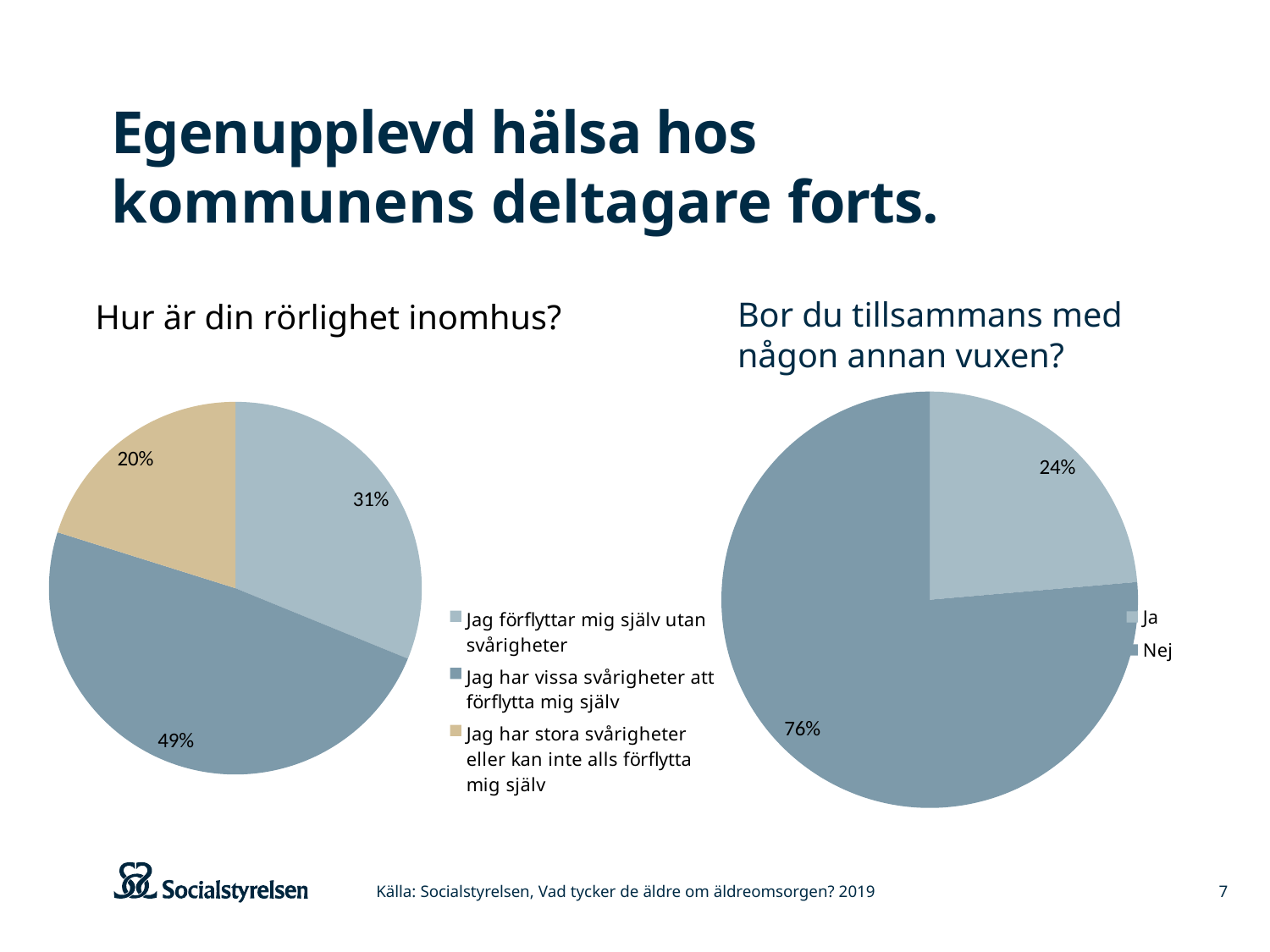
How many entries does the legend of the chart titled "Bor du tillsammans med någon annan vuxen?" list? 2 In the chart titled "Bor du tillsammans med någon annan vuxen?", what share answered "Nej"? 76% In the chart titled "Hur är din rörlighet inomhus?", which answer has the largest slice? Jag har vissa svårigheter att förflytta mig själv In the chart titled "Hur är din rörlighet inomhus?", what share of respondents answered "Jag har vissa svårigheter att förflytta mig själv"? 49% In the chart titled "Hur är din rörlighet inomhus?", what share of respondents answered "Jag förflyttar mig själv utan svårigheter"? 31% In the chart titled "Bor du tillsammans med någon annan vuxen?", what share answered "Ja"? 24% In the chart titled "Hur är din rörlighet inomhus?", what is the difference in percentage points between the "vissa svårigheter" slice and the "utan svårigheter" slice? 18 percentage points In the chart titled "Hur är din rörlighet inomhus?", what share of respondents answered "Jag har stora svårigheter eller kan inte alls förflytta mig själv"? 20% In the chart titled "Hur är din rörlighet inomhus?", which answer has the smallest slice? Jag har stora svårigheter eller kan inte alls förflytta mig själv In the chart titled "Bor du tillsammans med någon annan vuxen?", which answer is larger, "Ja" or "Nej"? Nej How many slices does the chart titled "Hur är din rörlighet inomhus?" have? 3 What type of chart is used for "Bor du tillsammans med någon annan vuxen?"? Pie chart